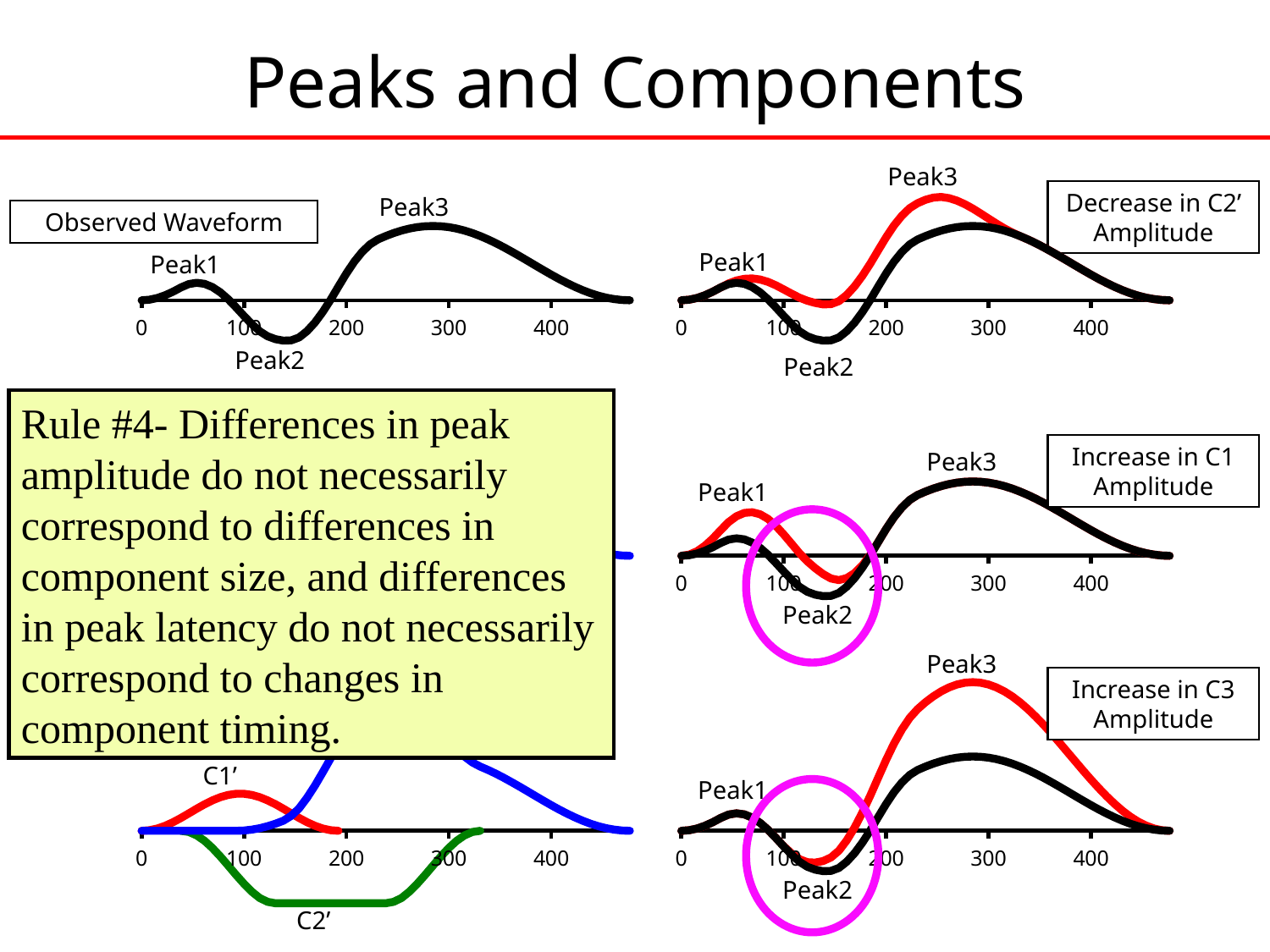
In the Observed Waveform panel, is Peak2 located at an x value greater or less than 100? greater In the 'Decrease in C2' Amplitude' panel, which line has the higher Peak3, the red line or the black line? red What is the largest x-axis tick value shown on the Observed Waveform panel? 400 In the Observed Waveform panel, which labelled peak is the lowest? Peak2 In the 'Increase in C1 Amplitude' panel, which line has the higher Peak1, the red line or the black line? red In the 'Increase in C3 Amplitude' panel, which line has the higher Peak3, the red line or the black line? red In the bottom-left panel, what colour is the line labelled C2'? green What kind of chart is the Observed Waveform panel? line chart In the Observed Waveform panel, which labelled peak is the highest? Peak3 In the Observed Waveform panel, how many peaks are labelled? 3 In the Observed Waveform panel, is Peak1 located at an x value greater or less than 100? less In the Observed Waveform panel, is Peak3 located at an x value greater or less than 200? greater